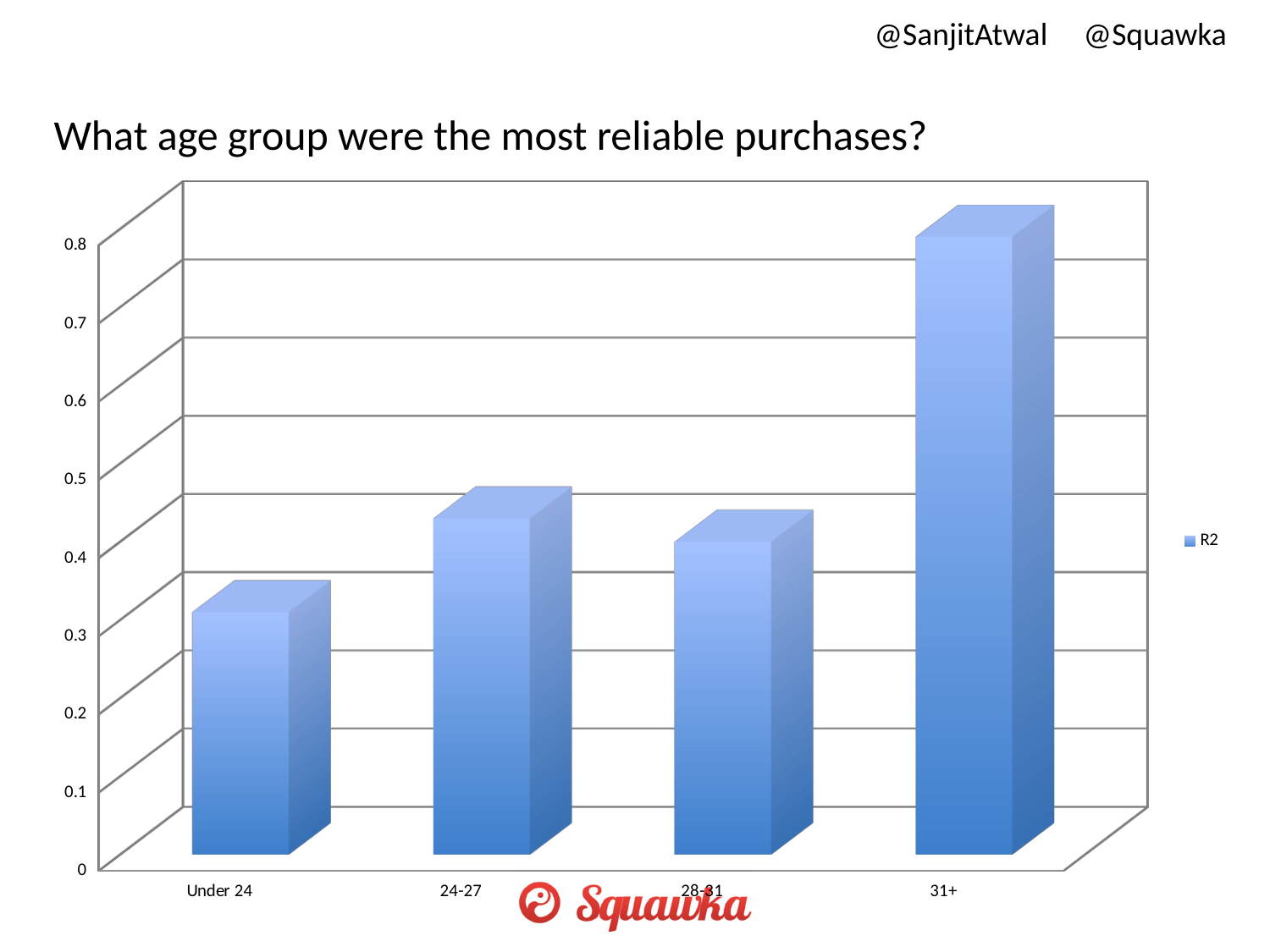
Is the value for 24-27 greater or less than 0.3? greater How many age groups are shown on the x axis? 4 What kind of chart is shown on the slide? bar chart Which age group has the highest value? 31+ What series name is shown in the legend? R2 Which age group has the lowest value? Under 24 What is the title of the chart? What age group were the most reliable purchases? Is the value for 31+ greater or less than 0.7? greater How many series does the legend list? 1 Is the value for 24-27 greater or less than 0.5? less Which is larger, the value for 24-27 or the value for Under 24? 24-27